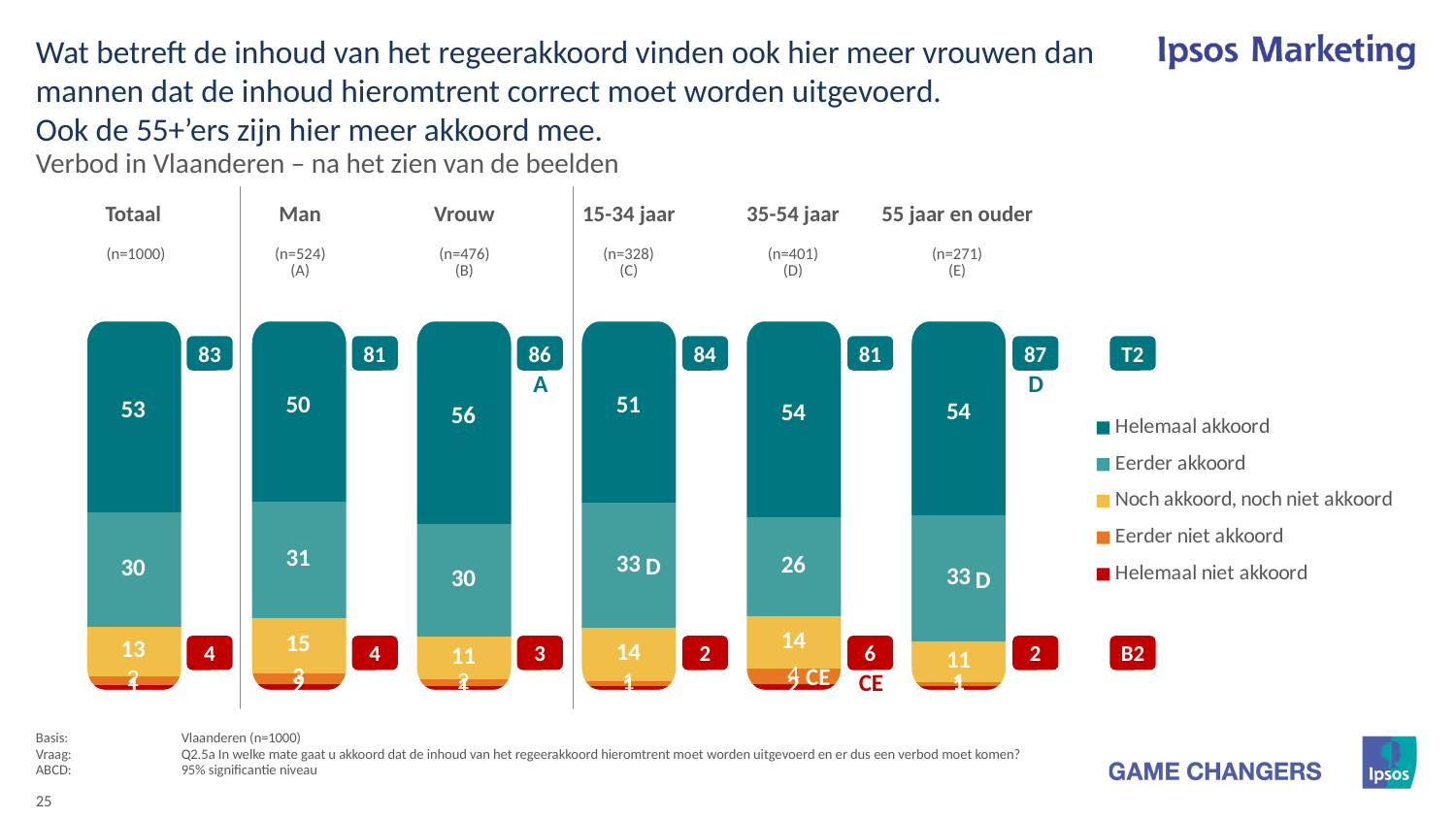
Which category has the lowest 'Eerder akkoord' value? 35-54 jaar What is the value for 'Eerder akkoord' in the 35-54 jaar bar? 26 What is the difference between the 'Helemaal akkoord' values for Vrouw and Man? 6 What is the B2 value shown for 35-54 jaar? 6 How many categories (bars) are shown in the chart? 6 What is the value for 'Helemaal akkoord' in the Vrouw bar? 56 What is the difference between the T2 values for Vrouw and Man? 5 Which has the larger 'Noch akkoord, noch niet akkoord' value, Man or Vrouw? Man What is the T2 value shown for 55 jaar en ouder? 87 How many series does the legend list? 5 What kind of chart is shown on the slide? Stacked bar chart Which category has the highest 'Helemaal akkoord' value? Vrouw